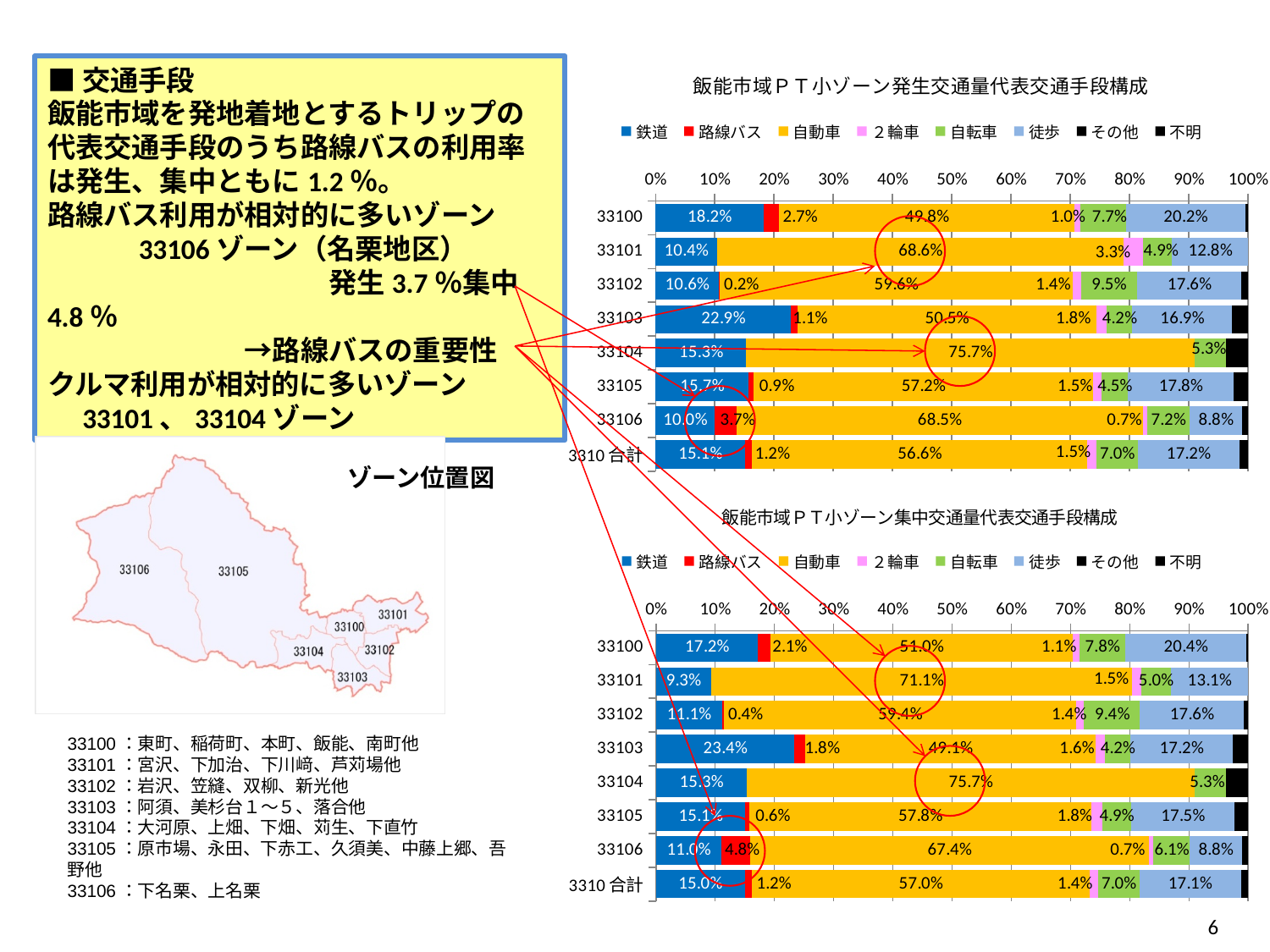
How many zone categories (including 3310合計) are shown in the bottom chart? 8 How many series does the legend of the top chart list? 8 In the bottom chart (集中交通量), what is the 鉄道 share for zone 33103? 23.4% In the top chart (発生交通量), what is the 路線バス share for zone 33106? 3.7% In the top chart (発生交通量), what is the difference between the 自動車 share of zone 33104 and that of zone 33100? 25.9% In the bottom chart (飯能市域ＰＴ小ゾーン集中交通量代表交通手段構成), what is the 路線バス share for zone 33106? 4.8% What kind of chart is the top chart (発生交通量)? Stacked bar chart In the bottom chart (集中交通量), which is larger: the 徒歩 share of zone 33100 or of zone 33106? 33100 In the top chart (発生交通量), what is the 路線バス share for 3310合計? 1.2% In the bottom chart (集中交通量), which zone has the lowest 鉄道 share? 33101 In the top chart (飯能市域ＰＴ小ゾーン発生交通量代表交通手段構成), what is the 自動車 share for zone 33104? 75.7% In the top chart (発生交通量), which zone has the highest 鉄道 share? 33103